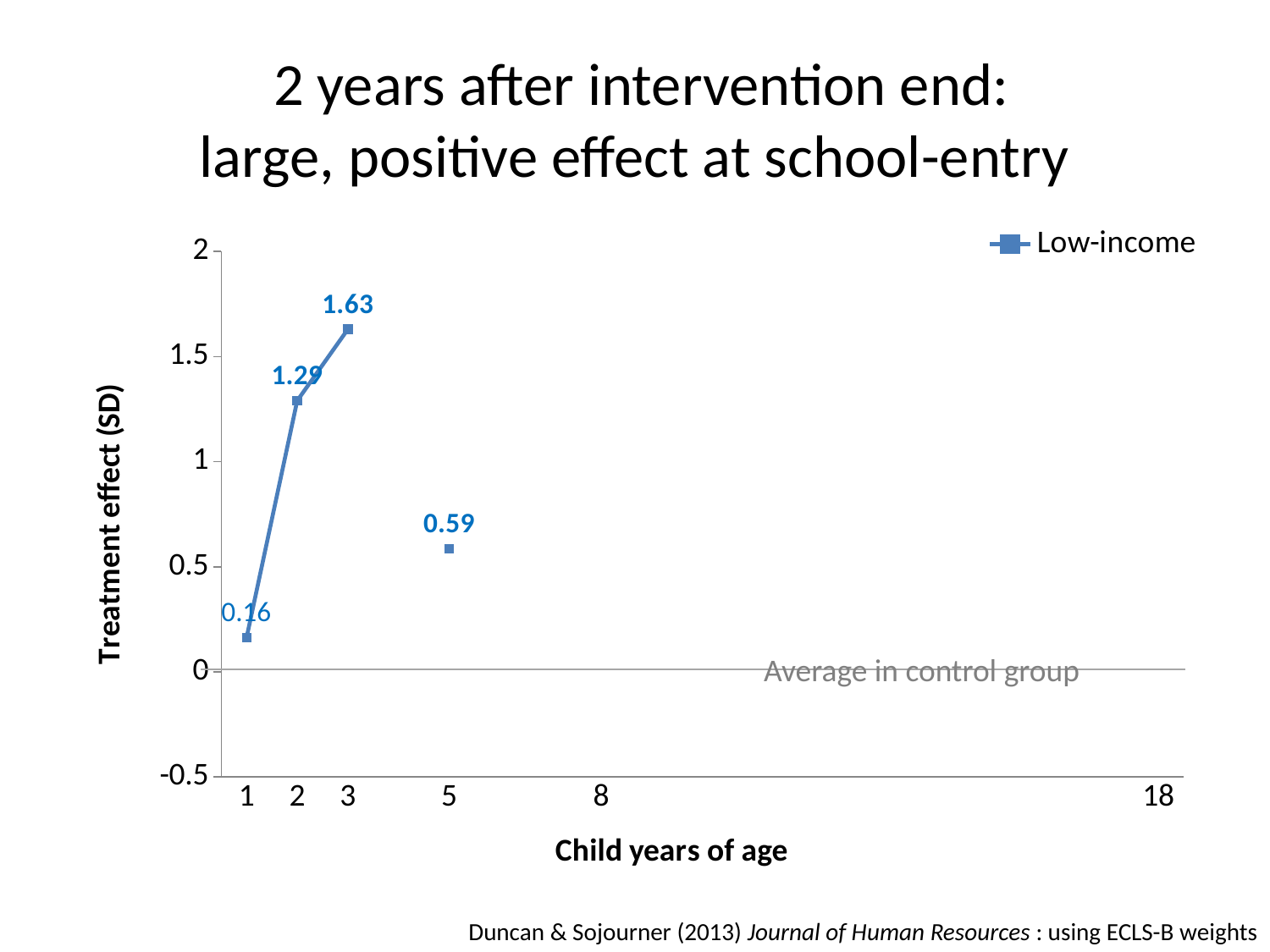
What kind of chart is shown on the slide? line chart At which child age is the treatment effect lowest? 1 How many data points are plotted on the chart? 4 How many series does the legend list? 1 What is the treatment effect for low-income children at age 5? 0.59 What is the label on the y axis of the chart? Treatment effect (SD) What is the treatment effect for low-income children at age 1? 0.16 At which child age is the treatment effect highest? 3 Which is larger, the treatment effect at age 2 or at age 5? age 2 What is the treatment effect for low-income children at age 3? 1.63 What is the difference between the treatment effect at age 3 and at age 2? 0.34 Is the treatment effect at age 2 greater or less than 1? greater